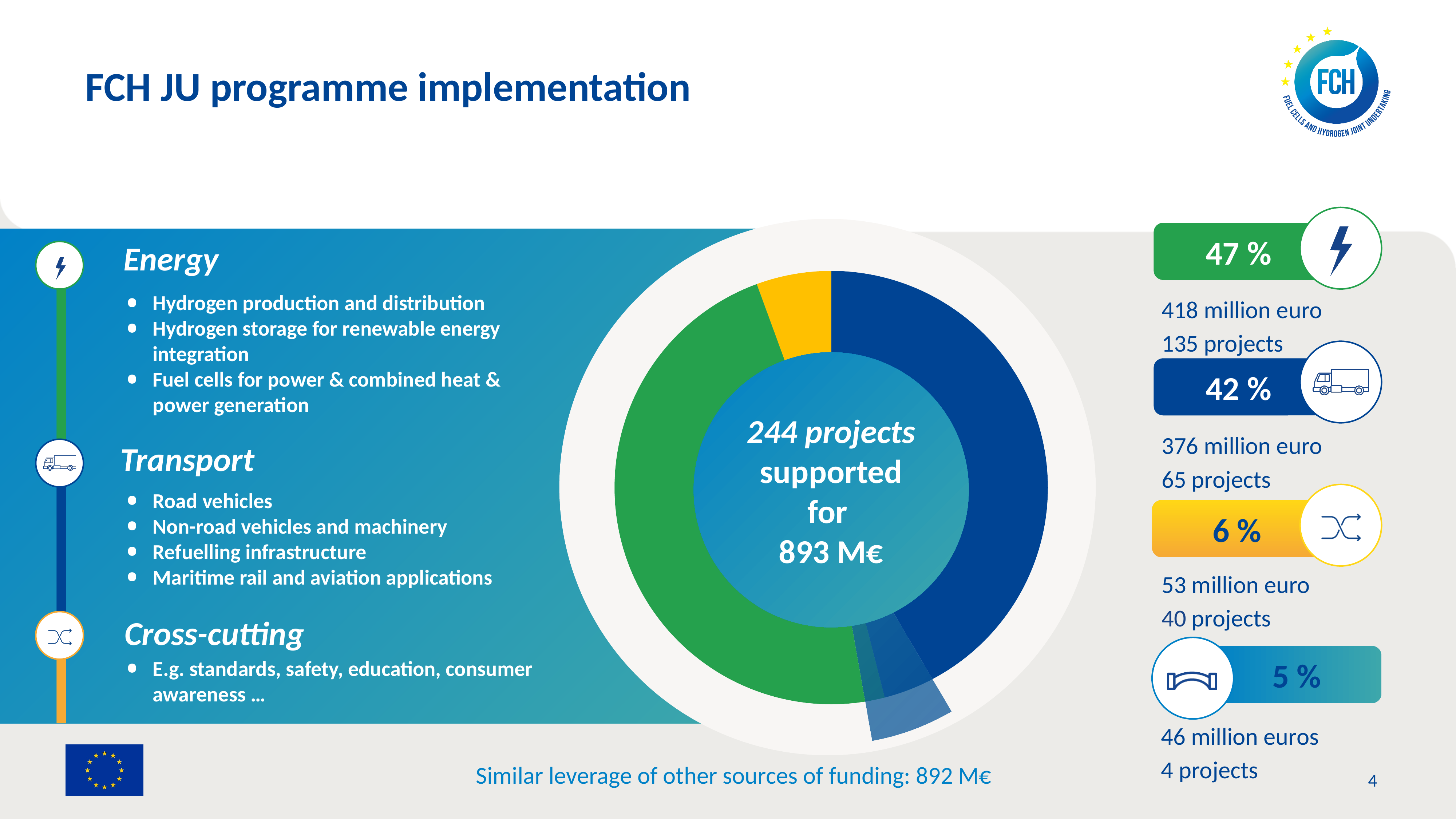
How many million euro are shown for the Cross-cutting segment? 53 million euro How many projects are shown for the Transport segment? 65 projects What is the difference in percentage points between the Energy share and the Transport share? 5 percentage points How many segments does the donut chart have? 4 What share of the donut chart does the yellow Cross-cutting segment represent? 6 % Which segment of the donut chart has the smallest share? The 5 % segment (46 million euros, 4 projects) What kind of chart is shown in the centre of the slide? Donut (pie) chart Which has more projects, Energy or Transport? Energy How many million euro are shown for the Energy segment? 418 million euro What share of the donut chart does the dark blue Transport segment represent? 42 % What share of the donut chart does the green Energy segment represent? 47 % Which segment of the donut chart has the largest share? Energy (47 %)